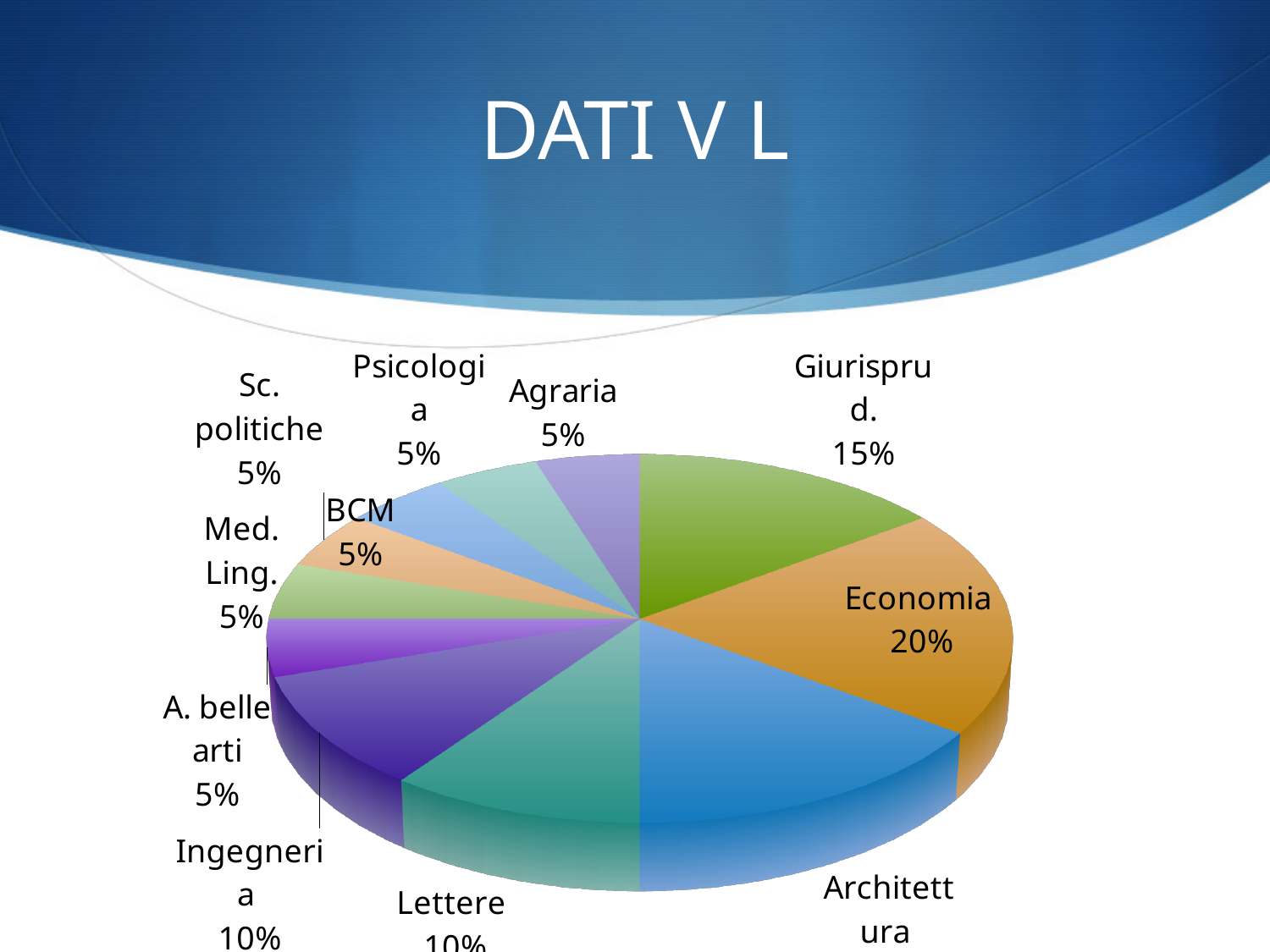
What is the share for Ingegneria? 10% What is the share for Giurisprud.? 15% What is the share for Economia? 20% What is the title of the slide? DATI V L What is the share for BCM? 5% How many slices does the pie chart have? 11 Which has a larger share, Economia or Ingegneria? Economia What is the share for Agraria? 5% What kind of chart is shown on the slide? pie chart Which has a larger share, Giurisprud. or Sc. politiche? Giurisprud. What is the difference between the shares of Giurisprud. and Psicologia? 10% What is the difference between the shares of Economia and Giurisprud.? 5%